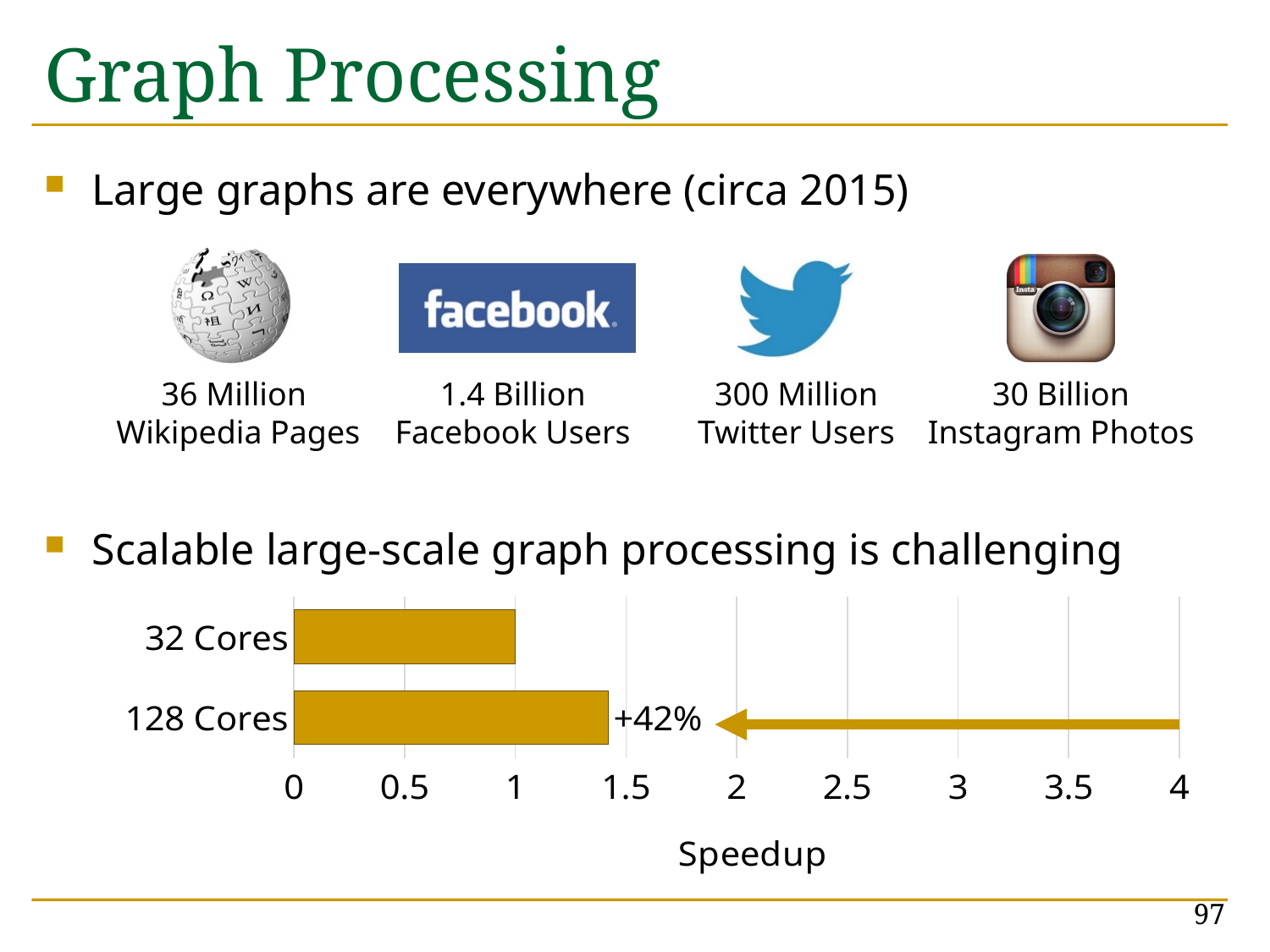
What is the speedup value for 32 Cores? 1 What is the label of the horizontal axis of the chart? Speedup What percentage annotation is shown next to the 128 Cores bar? +42% Which category has the lowest speedup? 32 Cores Is the speedup for 128 Cores greater or less than 1? greater What is the maximum value shown on the horizontal axis of the chart? 4 What type of chart is shown on the slide? bar chart Is the speedup for 128 Cores greater or less than 2? less How many categories does the chart show? 2 Is the speedup for 128 Cores greater or less than 1.5? less Which has a larger speedup, 32 Cores or 128 Cores? 128 Cores Which category has the highest speedup? 128 Cores